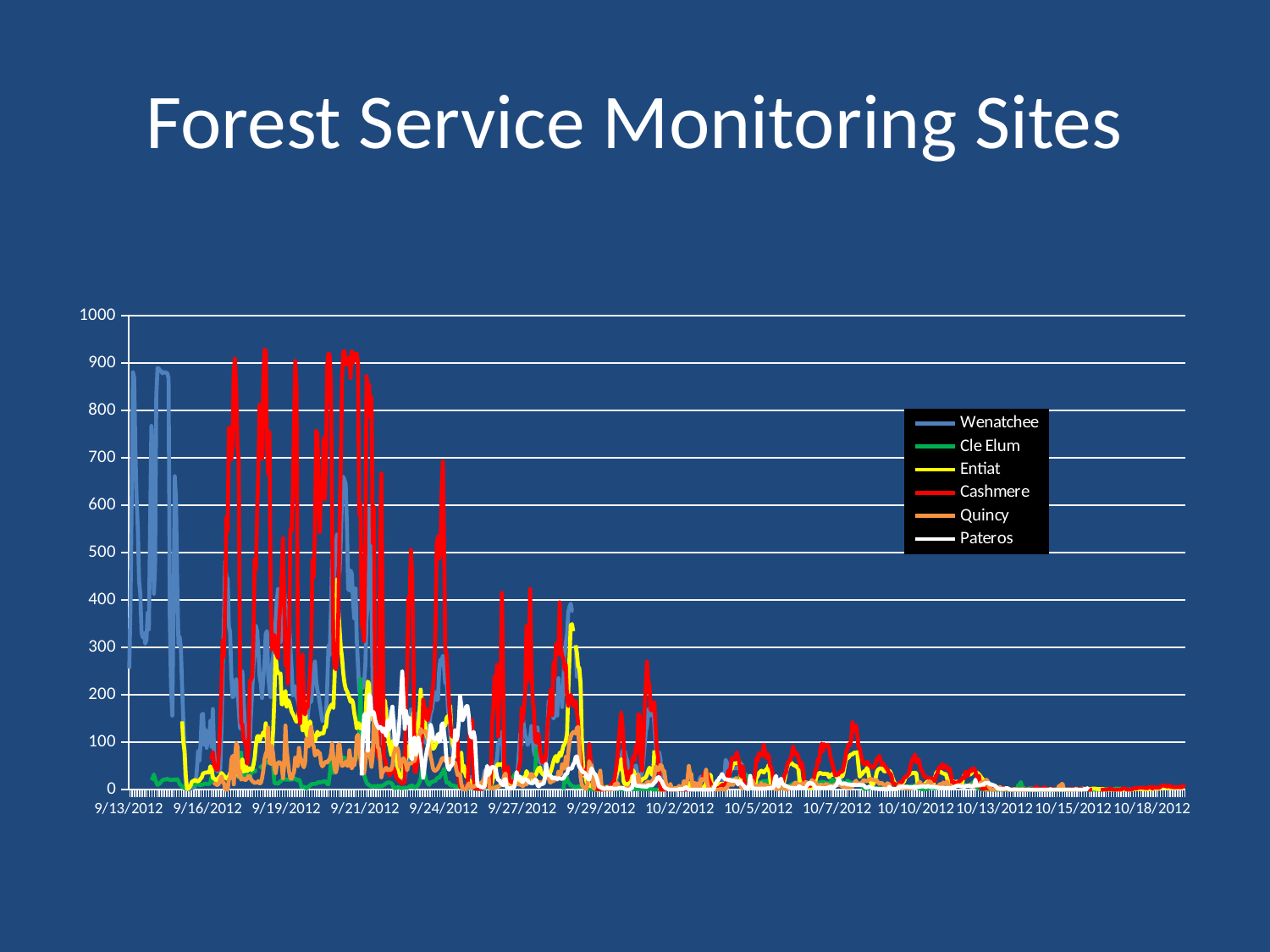
What kind of chart is shown on the slide? line chart Overall, do the values rise or fall from 9/13/2012 to 10/18/2012? fall Is the highest value reached by the Cashmere series greater or less than 800? greater What is the title of the slide containing the chart? Forest Service Monitoring Sites Is the highest value reached by the Pateros series greater or less than 400? less Is the highest value reached by the Cle Elum series greater or less than 300? less Which series reaches a higher peak, Cashmere or Quincy? Cashmere Which colour is used for the Cashmere series? red How many series does the legend list? 6